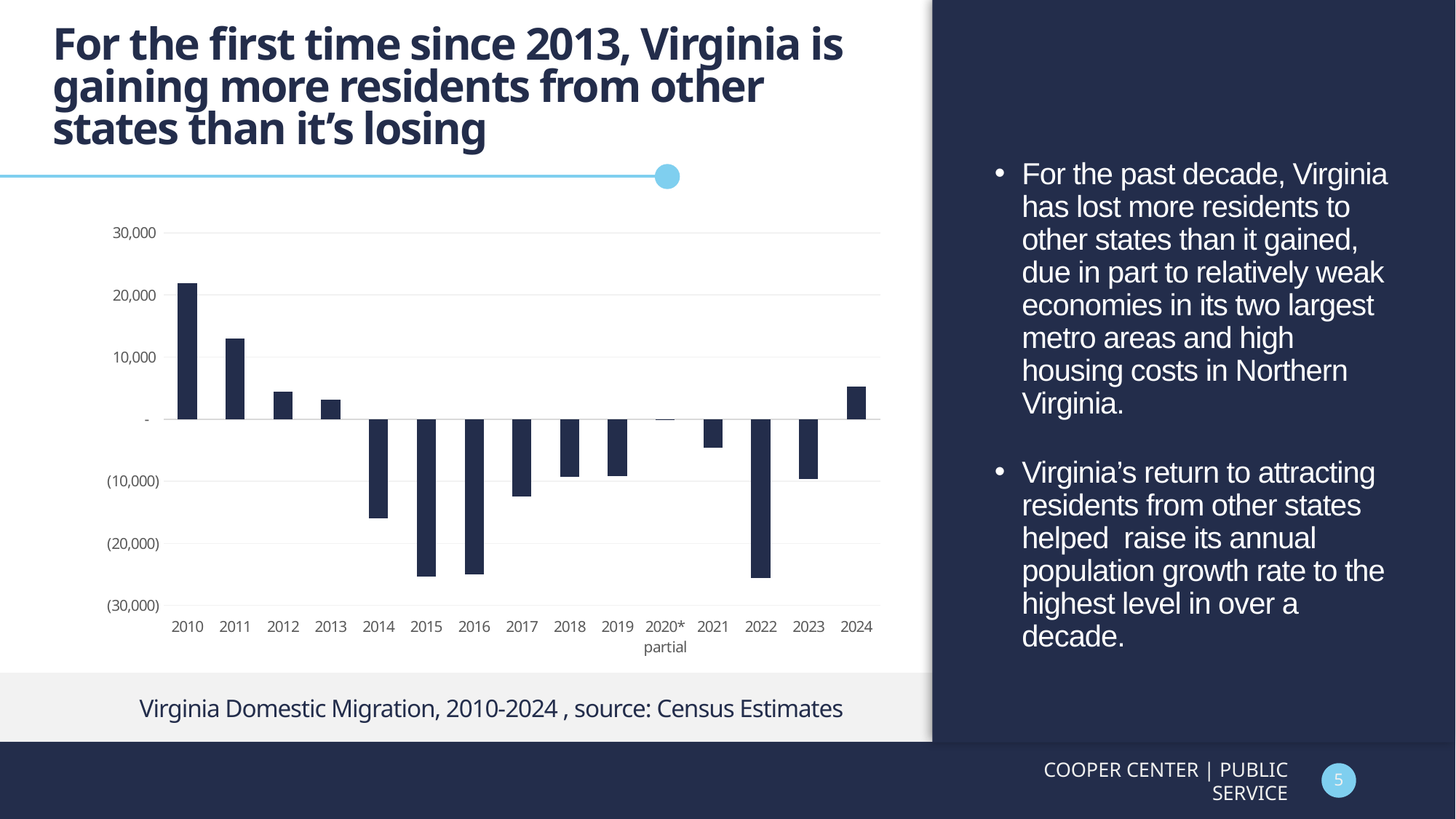
Do the values rise or fall from 2010 to 2013? fall What kind of chart is shown on the slide? bar chart Which year has the highest value in the chart? 2010 Is the value for 2017 greater or less than (10,000)? less Is the value for 2010 greater or less than 20,000? greater Which is larger, the value for 2017 or the value for 2014? 2017 Is the value for 2014 greater or less than (10,000)? less Which is larger, the value for 2010 or the value for 2011? 2010 Which year on the x axis is marked as partial? 2020 How many years are plotted on the x axis of the chart? 15